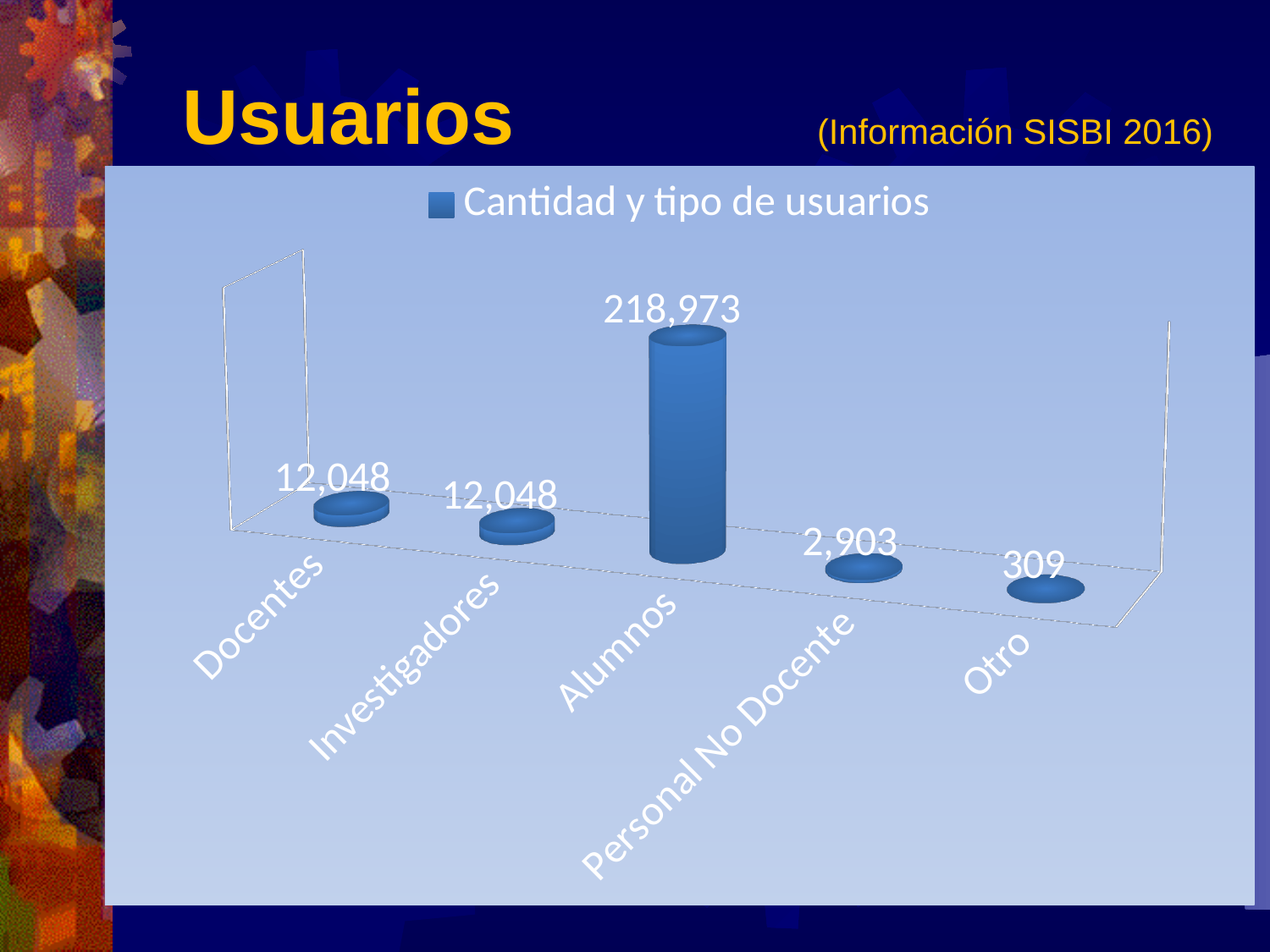
Which is larger, the value for Investigadores or the value for Personal No Docente? Investigadores Which category has the lowest value? Otro What kind of chart is shown on the slide? Bar chart Which category has the highest value? Alumnos What is the value for Otro? 309 What is the value for Personal No Docente? 2,903 What series name does the legend show? Cantidad y tipo de usuarios What is the difference between the values for Personal No Docente and Otro? 2,594 What is the value for Alumnos? 218,973 What is the value for Docentes? 12,048 How many categories are shown on the chart? 5 What is the difference between the values for Alumnos and Docentes? 206,925